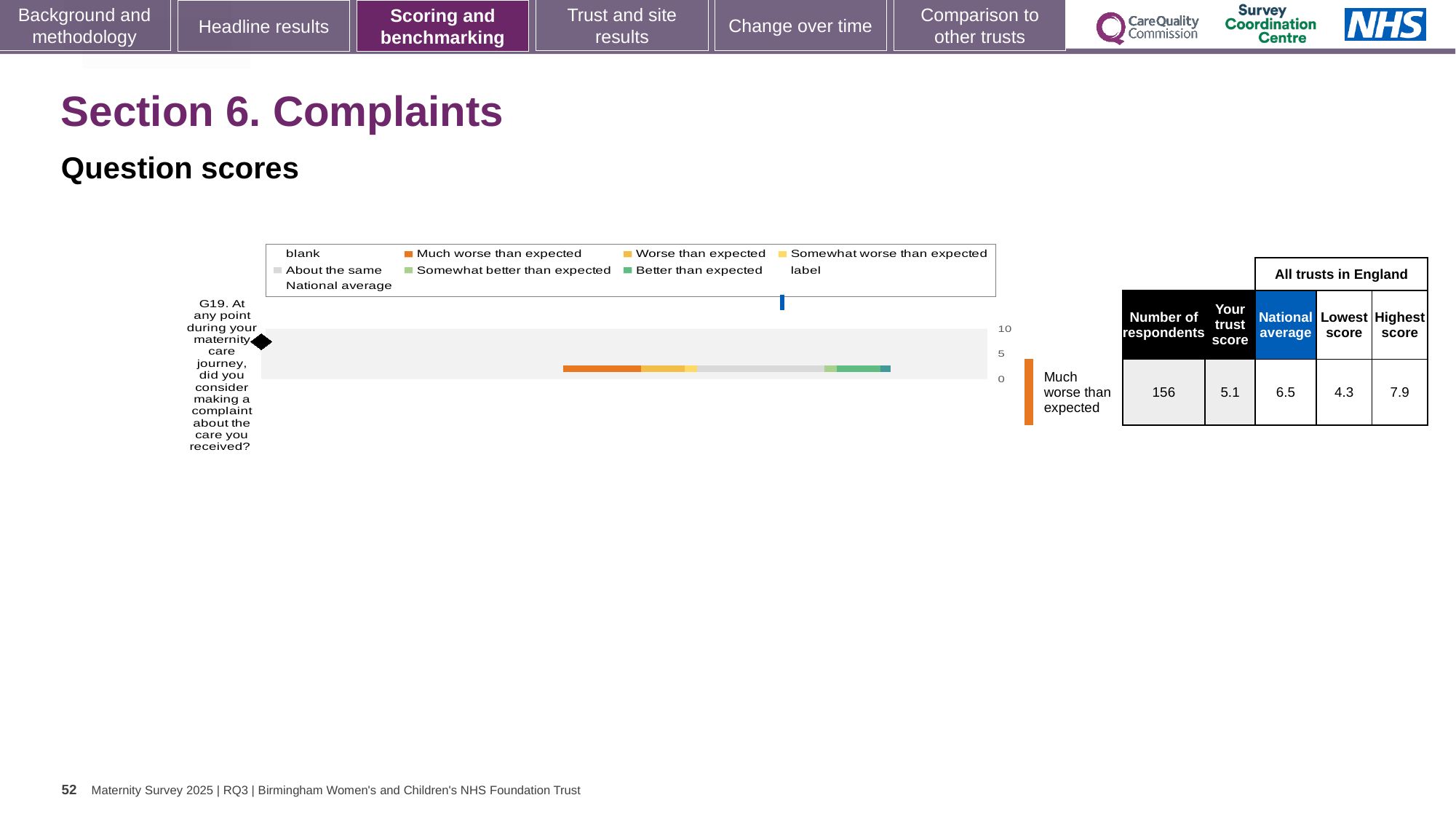
How many respondents answered question G19? 156 What is the lowest score among all trusts in England for question G19? 4.3 Is the trust score for question G19 greater or less than 5? greater Which benchmarking category is shown next to the bar for question G19? Much worse than expected How many survey questions are plotted in the chart on the slide? 1 What is the trust score for question G19 shown in the table? 5.1 What is the difference between the national average and the trust score for question G19? 1.4 What is the national average for question G19 shown in the table? 6.5 What is the highest score among all trusts in England for question G19? 7.9 What is the difference between the highest score and the lowest score for question G19? 3.6 What kind of chart is shown on the slide for question G19? bar chart Which is larger for question G19, the trust score or the national average? National average